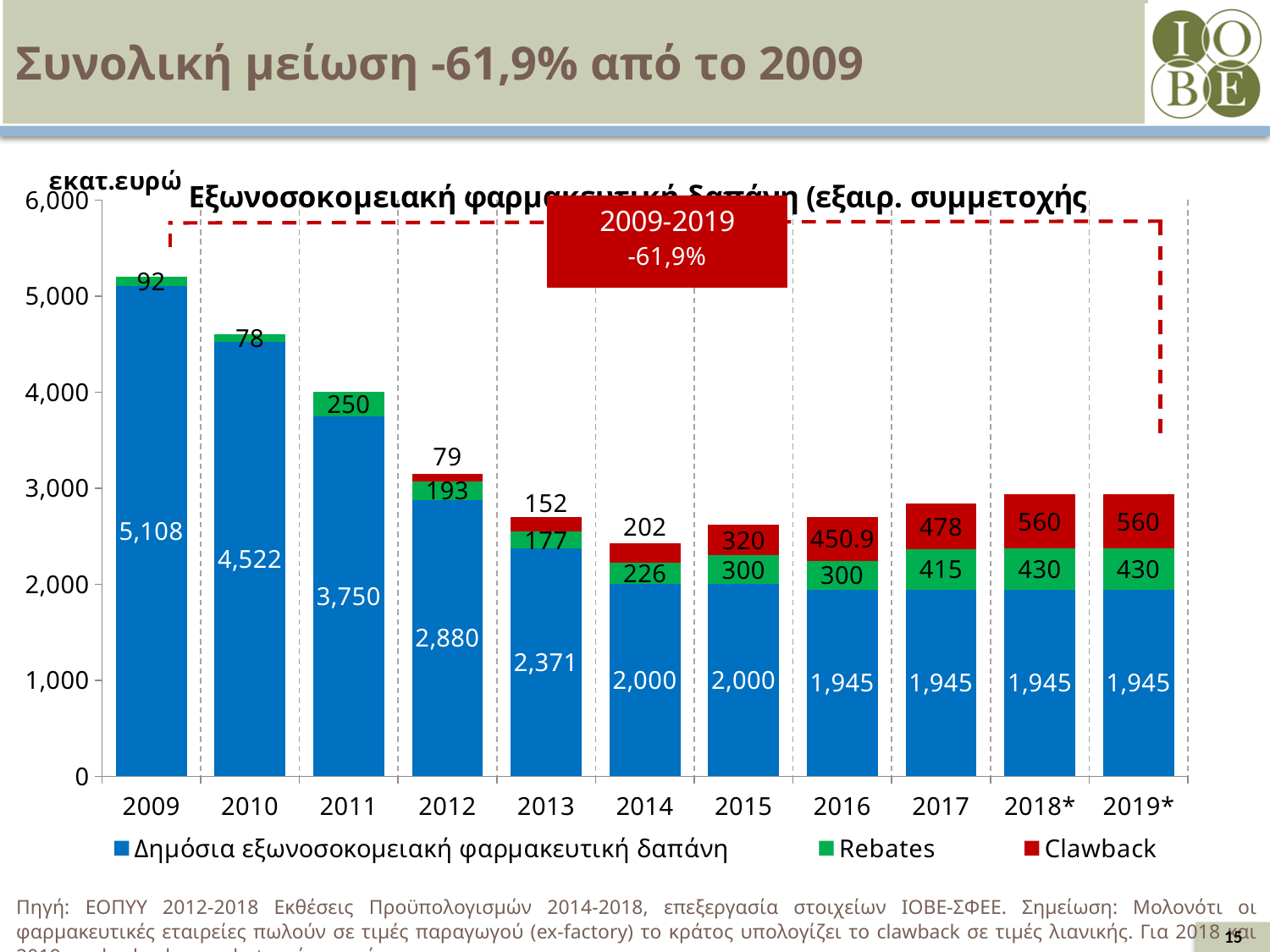
What is the Rebates value for 2011? 250 What is the total of the stacked bar for 2018*? 2,935 How many series does the legend list? 3 What is the difference between the Δημόσια εξωνοσοκομειακή φαρμακευτική δαπάνη values for 2010 and 2011? 772 How many years are shown on the x axis? 11 Which is larger, the Rebates value for 2017 or the Rebates value for 2014? 2017 What is the value of Δημόσια εξωνοσοκομειακή φαρμακευτική δαπάνη for 2009? 5,108 What is the Clawback value for 2016? 450.9 Which year has the highest value for Δημόσια εξωνοσοκομειακή φαρμακευτική δαπάνη? 2009 What kind of chart is shown on the slide? Stacked bar chart Is the total height of the 2013 stacked bar greater or less than 3,000? less Which year has the lowest Clawback value among the years where Clawback is shown? 2012